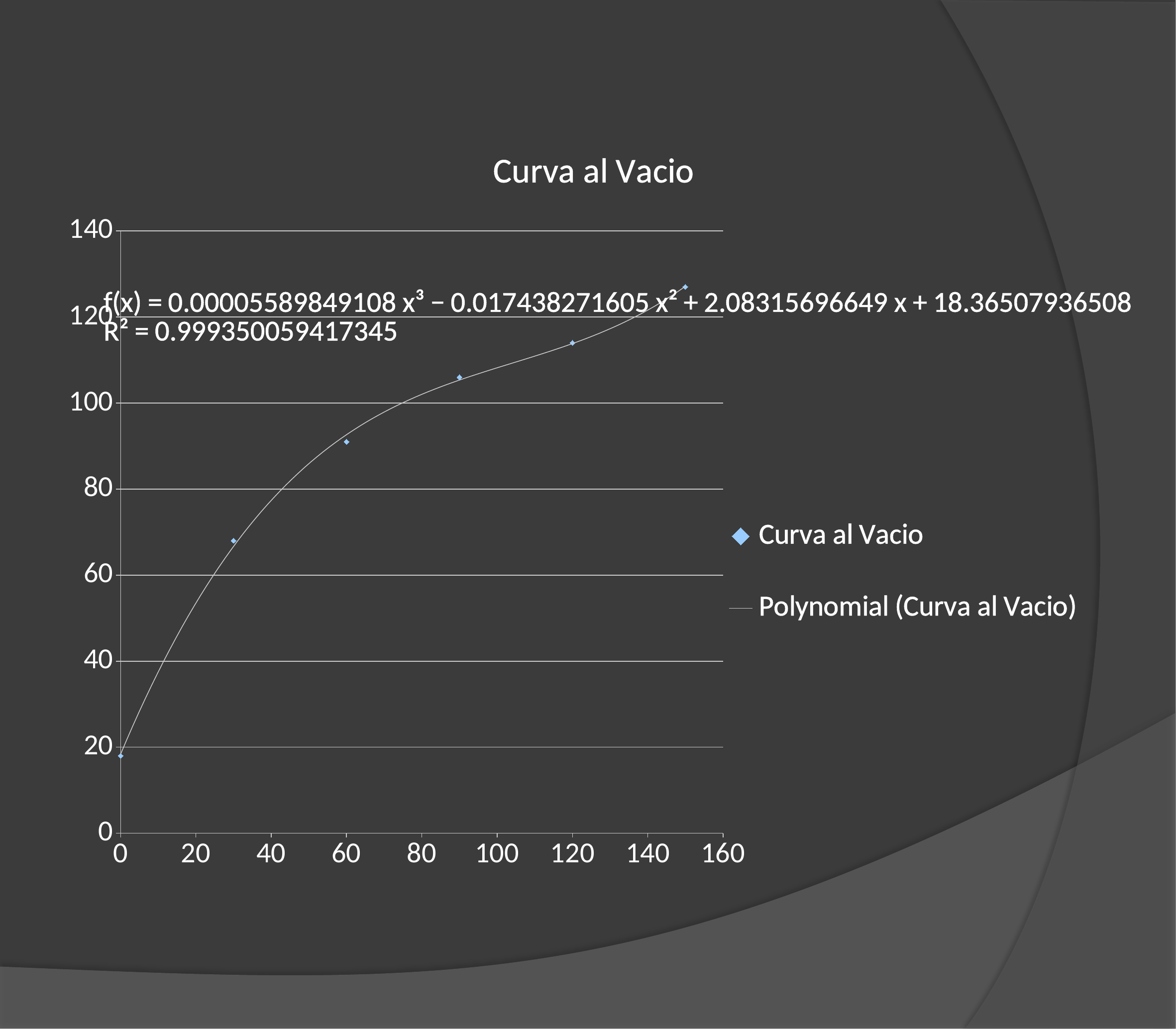
Is the value at x = 0 greater or less than 40? less What kind of chart is shown on the slide? scatter chart At which x value is the plotted point highest? 150 Do the plotted values rise or fall as x increases from 0 to 160? rise How many data points are plotted for the Curva al Vacio series? 6 How many entries does the legend list? 2 What R² value is printed for the polynomial trendline? 0.999350059417345 Is the value at x = 30 greater or less than 60? greater At which x value is the plotted point lowest? 0 Is the value at x = 120 greater or less than 100? greater What is the title of the chart? Curva al Vacio